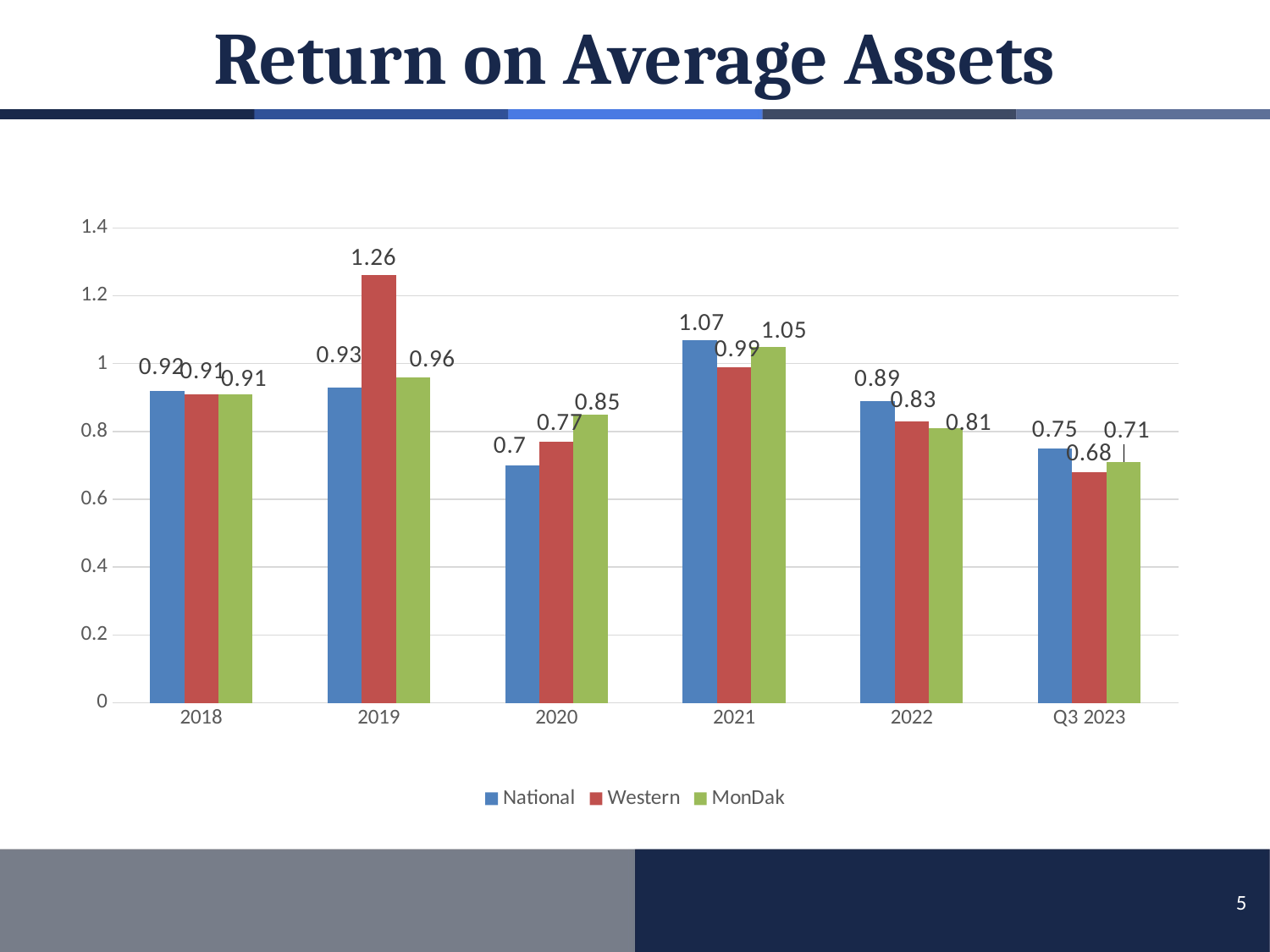
What kind of chart is shown on the slide? bar chart What is the difference between the Western and National values in 2019? 0.33 What is the MonDak value for Q3 2023? 0.71 Is the Western value for 2022 greater or less than 1? less Which year has the highest Western value? 2019 What is the National value for 2021? 1.07 What is the Western value for 2019? 1.26 Which category has the lowest National value? 2020 What is the title of the chart? Return on Average Assets Which is larger in 2020, the National value or the MonDak value? MonDak How many categories are shown on the x axis? 6 How many series does the legend list? 3